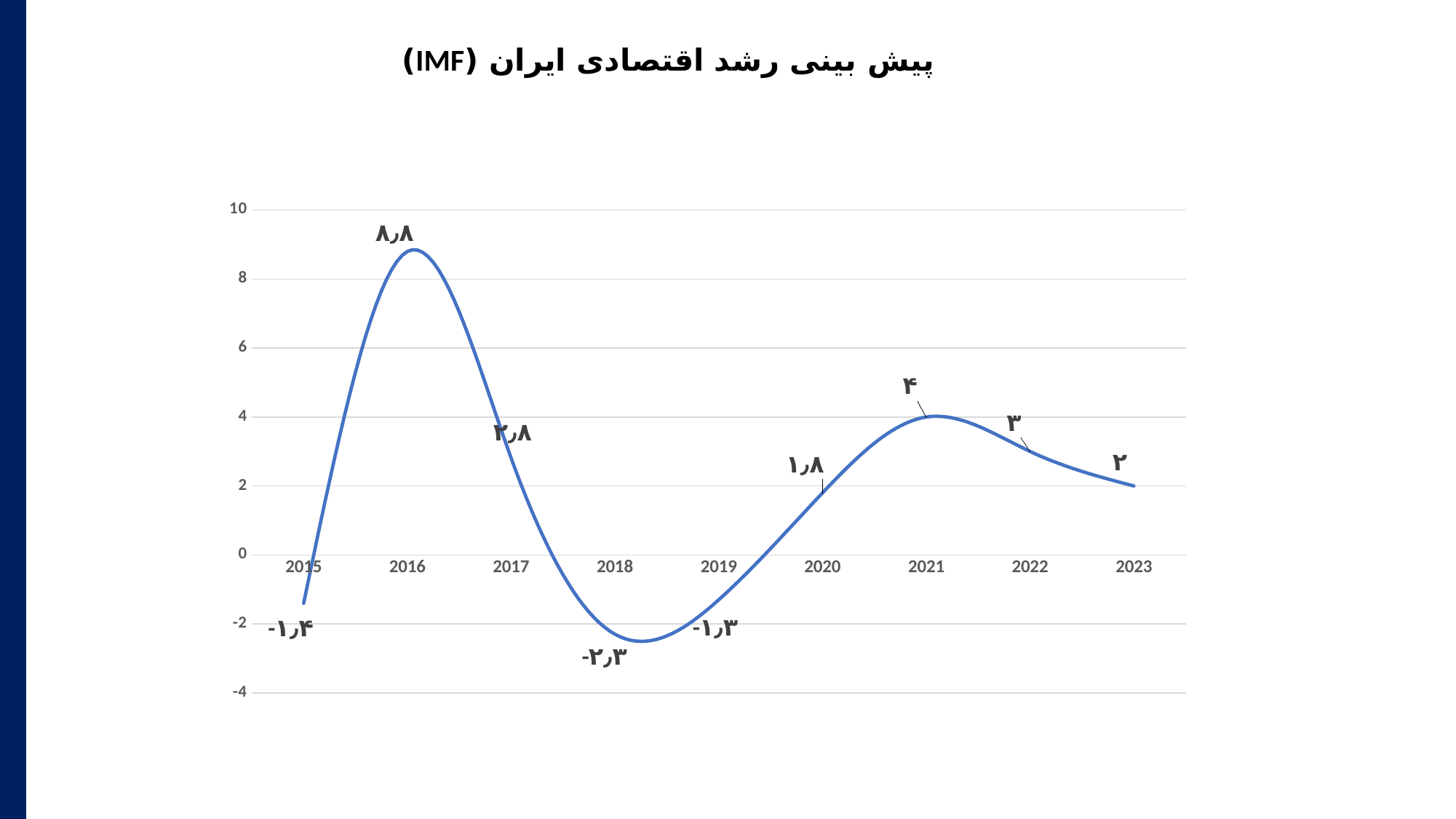
What is the value for 2018? -۲٫۳ What is the value for 2016? ۸٫۸ What is the value for 2021? ۴ What is the title of the chart? پیش بینی رشد اقتصادی ایران (IMF) Which year has the highest value? 2016 Is the value for 2016 greater or less than 8? greater Which year has the lowest value? 2018 How many years are plotted on the x axis? 9 What is the value for 2023? ۲ What type of chart is shown on the slide? line chart Do the values rise or fall from 2021 to 2023? fall Which is larger, the value for 2017 or the value for 2022? 2022